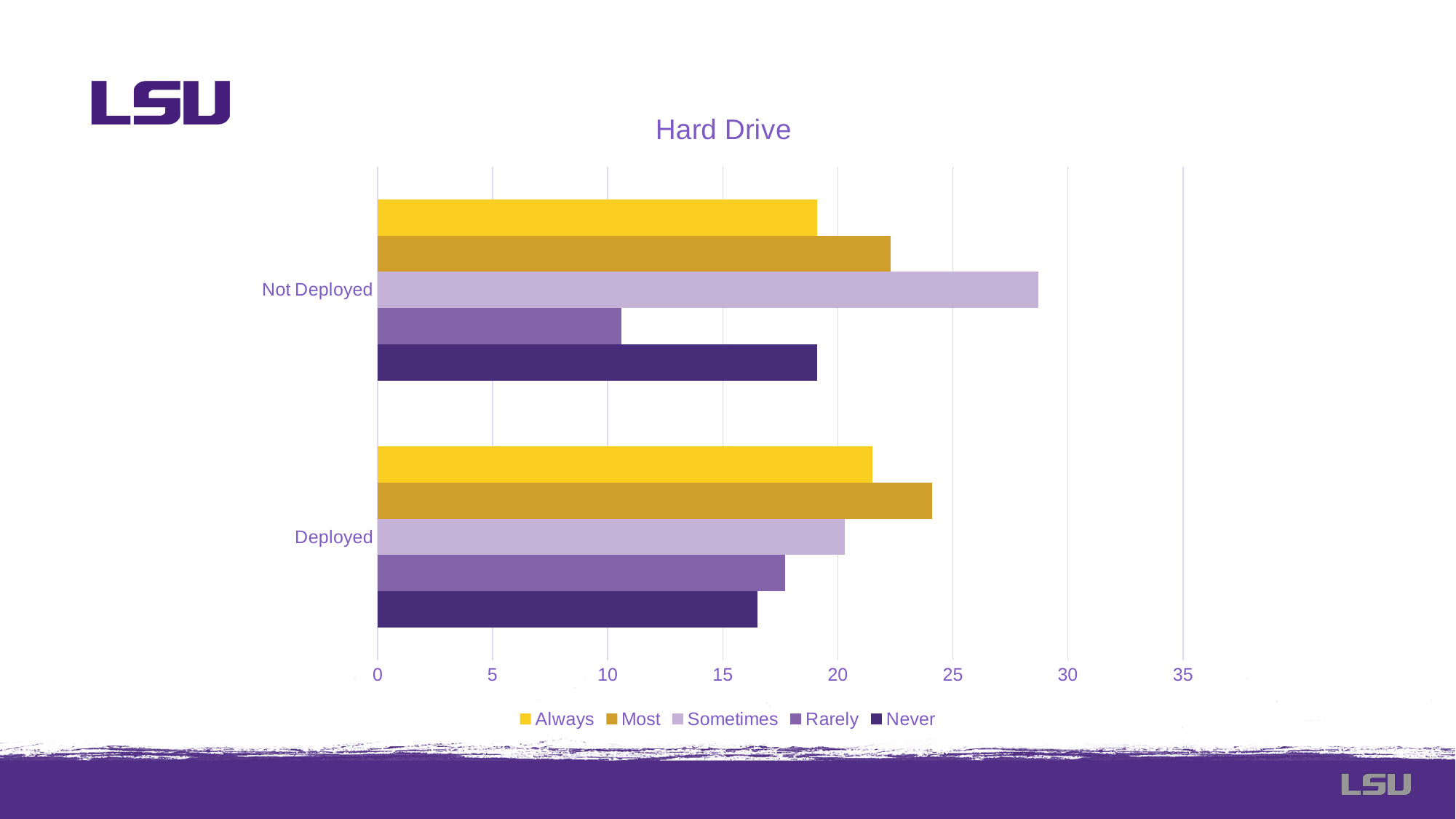
Within the Deployed category, which series has the longest bar? Most Is the Sometimes value for Not Deployed greater or less than 25? greater What kind of chart is shown on the slide? bar chart Is the Rarely value for Not Deployed greater or less than 15? less Within the Not Deployed category, which series has the shortest bar? Rarely What is the title of the chart? Hard Drive Is the Most value for Deployed greater or less than 20? greater How many series does the legend list? 5 How many categories are shown on the vertical axis? 2 Which has the larger Sometimes value, Not Deployed or Deployed? Not Deployed Which has the larger Rarely value, Not Deployed or Deployed? Deployed Within the Not Deployed category, which series has the longest bar? Sometimes